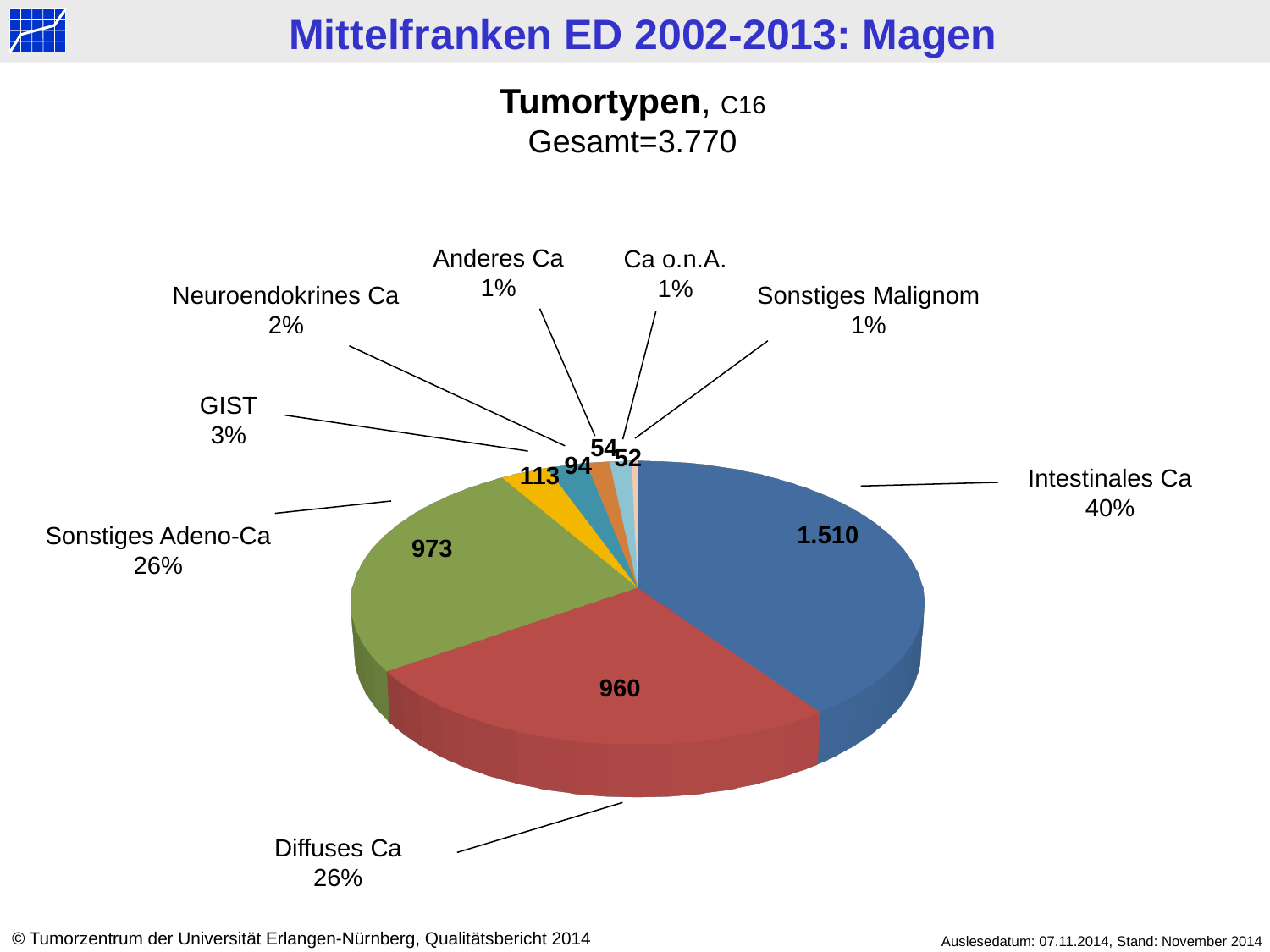
What is the value for Neuroendokrines Ca? 94 What is the value for Sonstiges Adeno-Ca? 973 How many tumour types are shown in the pie chart? 8 What is the value for Diffuses Ca? 960 What kind of chart is shown on the slide? pie chart Which tumour type has the largest slice? Intestinales Ca What share of the pie does GIST represent? 3% What is the value for GIST? 113 What share of the pie does Intestinales Ca represent? 40% What is the difference between the values for Intestinales Ca and Diffuses Ca? 550 What is the value for Intestinales Ca? 1.510 Which is larger, Sonstiges Adeno-Ca or Diffuses Ca? Sonstiges Adeno-Ca